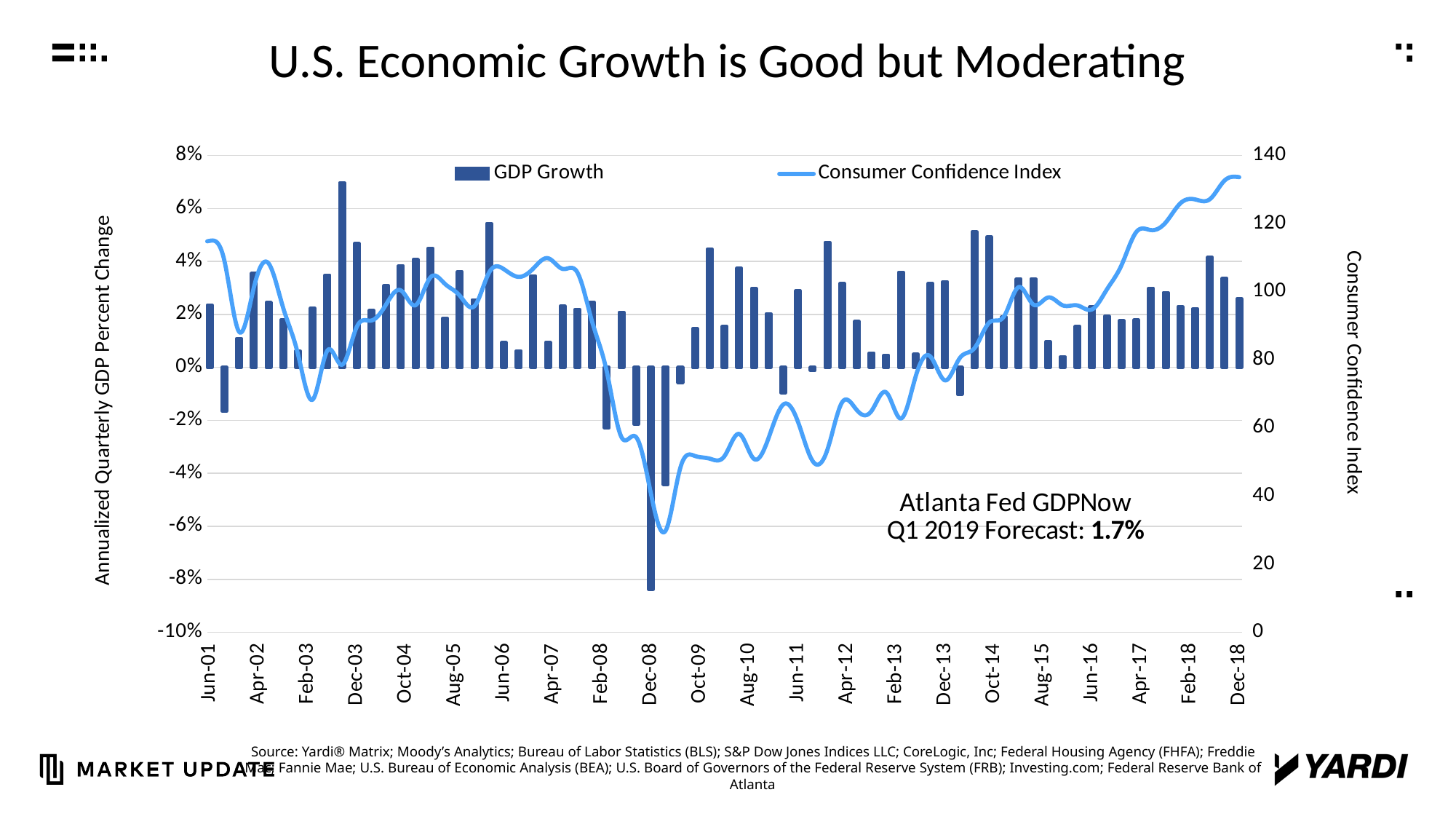
Is the Consumer Confidence Index higher at Jun-01 or at Dec-18? Dec-18 What are the two series named in the legend? GDP Growth and Consumer Confidence Index Is the Consumer Confidence Index value at Dec-18 greater or less than 120? greater Does the Consumer Confidence Index rise or fall between Jun-16 and Dec-18? rise In which year does the tallest GDP Growth bar occur? 2003 How many series does the chart legend list? 2 What is the title of the chart on the slide? U.S. Economic Growth is Good but Moderating What is the Atlanta Fed GDPNow Q1 2019 forecast shown on the chart? 1.7% Is the Consumer Confidence Index value at Jun-11 greater or less than 80? less What kind of chart is shown on the slide? A combined bar and line chart At which x-axis date does the lowest GDP Growth bar occur? Dec-08 Is the GDP Growth value for Dec-08 greater or less than -6%? less